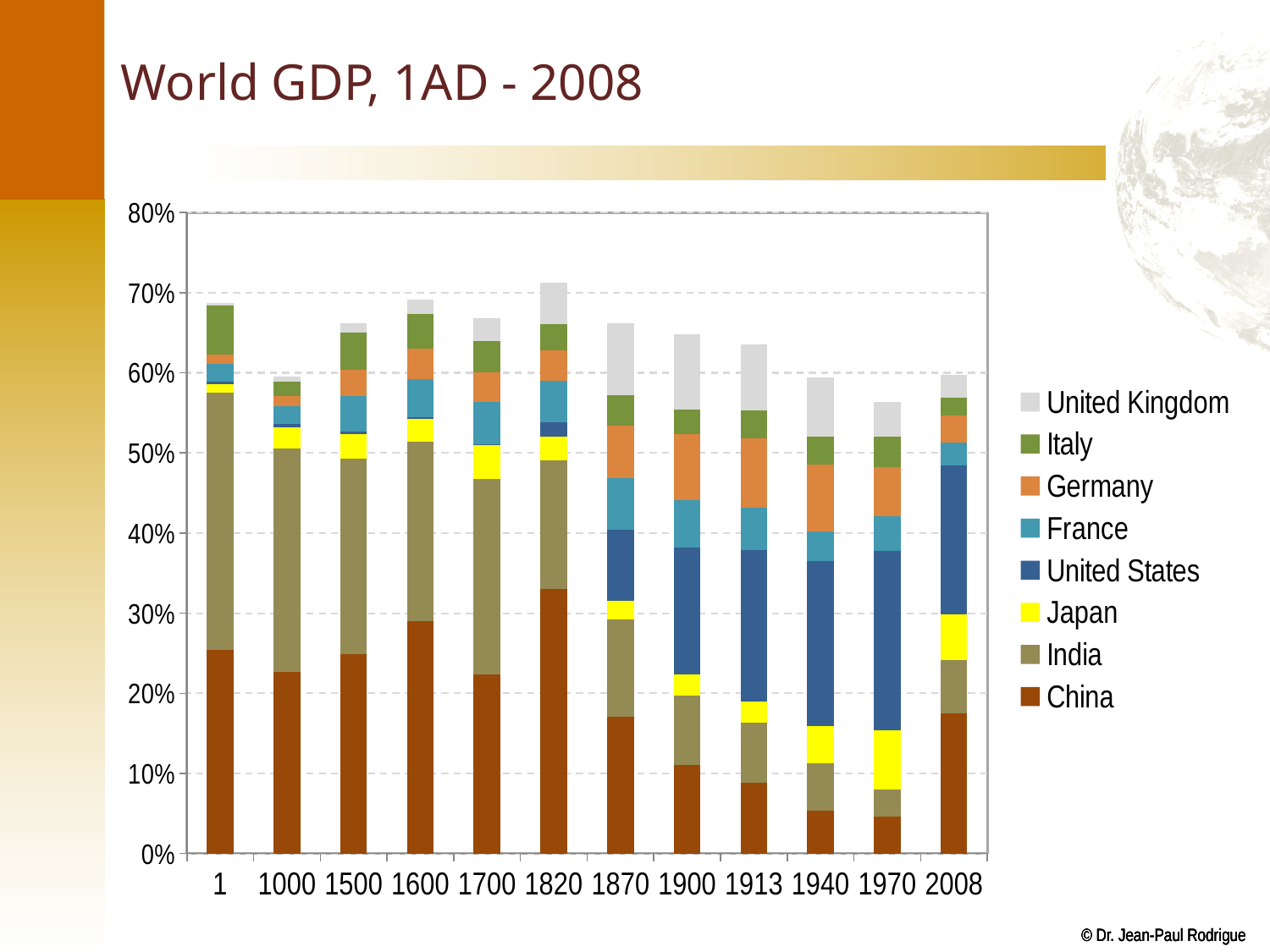
What kind of chart is shown on the slide? stacked bar chart Which series is listed at the top of the legend? United Kingdom Does China's share rise or fall from 1820 to 1970? fall Is the total height of the stacked bar for 1820 greater or less than 70%? greater Which year has the shortest stacked bar overall? 1970 Which year has the tallest stacked bar overall? 1820 How many series does the legend list? 8 Is the value for China in 1970 greater or less than 10%? less Is the total height of the stacked bar for 1970 greater or less than 60%? less Which is larger: China's share in year 1 or China's share in 2008? year 1 How many years (categories) are shown along the x axis? 12